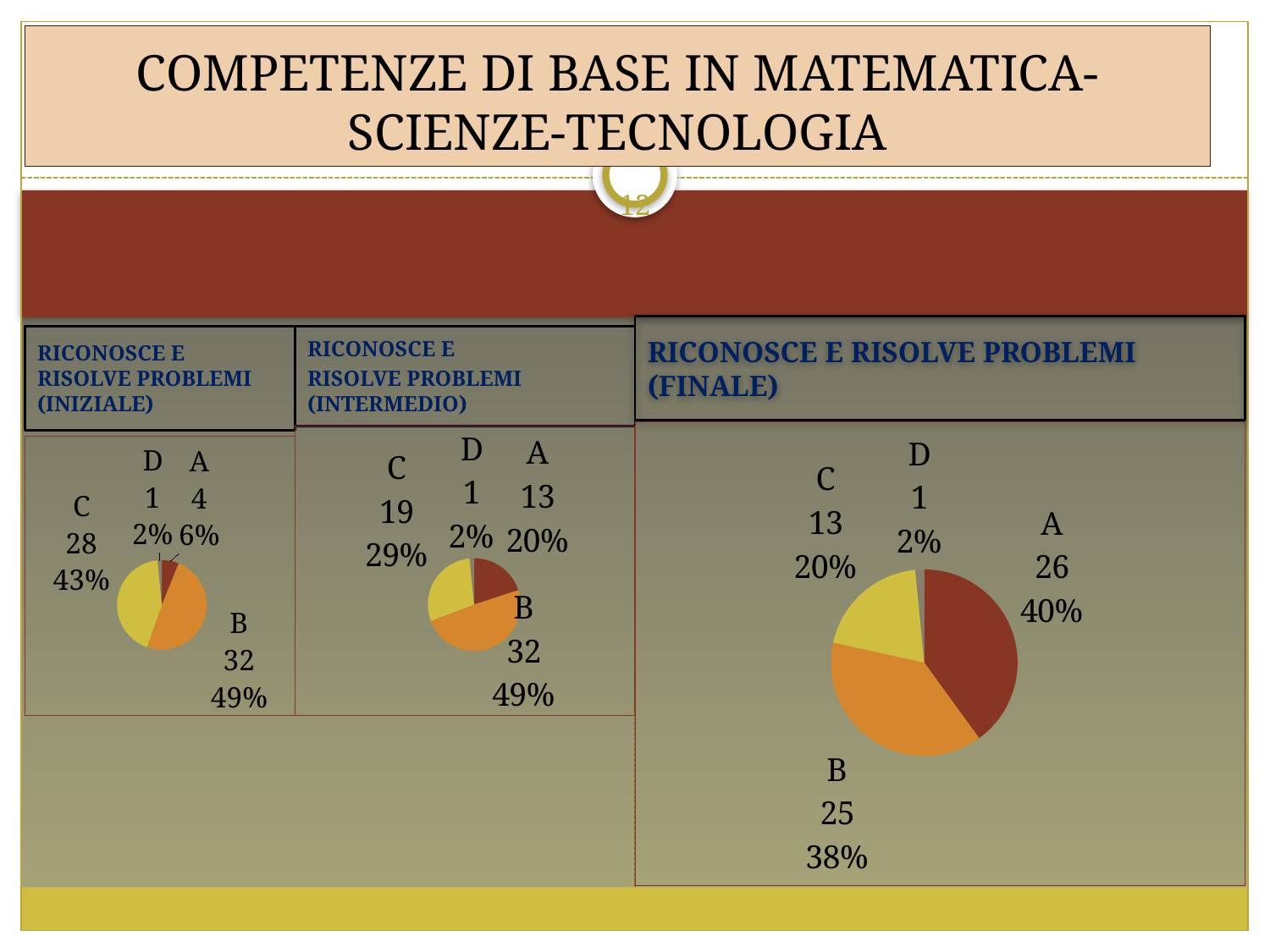
In the 'RICONOSCE E RISOLVE PROBLEMI (INIZIALE)' chart, what percentage share does category C have? 43% In the 'RICONOSCE E RISOLVE PROBLEMI (INTERMEDIO)' chart, what percentage share does category B have? 49% In the 'RICONOSCE E RISOLVE PROBLEMI (FINALE)' chart, which category has the lowest value? D In the 'RICONOSCE E RISOLVE PROBLEMI (FINALE)' chart, which is larger, the value for B or the value for C? B In the 'RICONOSCE E RISOLVE PROBLEMI (INTERMEDIO)' chart, what is the difference between the values for B and A? 19 How many pie charts are shown on the slide? 3 How many categories does the 'RICONOSCE E RISOLVE PROBLEMI (FINALE)' chart show? 4 In the 'RICONOSCE E RISOLVE PROBLEMI (INIZIALE)' chart, which category has the highest value? B In the 'RICONOSCE E RISOLVE PROBLEMI (INTERMEDIO)' chart, what is the value for category C? 19 What kind of chart is used for 'RICONOSCE E RISOLVE PROBLEMI (INIZIALE)'? Pie chart In the 'RICONOSCE E RISOLVE PROBLEMI (FINALE)' chart, what is the difference between the values for A and C? 13 In the 'RICONOSCE E RISOLVE PROBLEMI (FINALE)' chart, what is the value for category A? 26